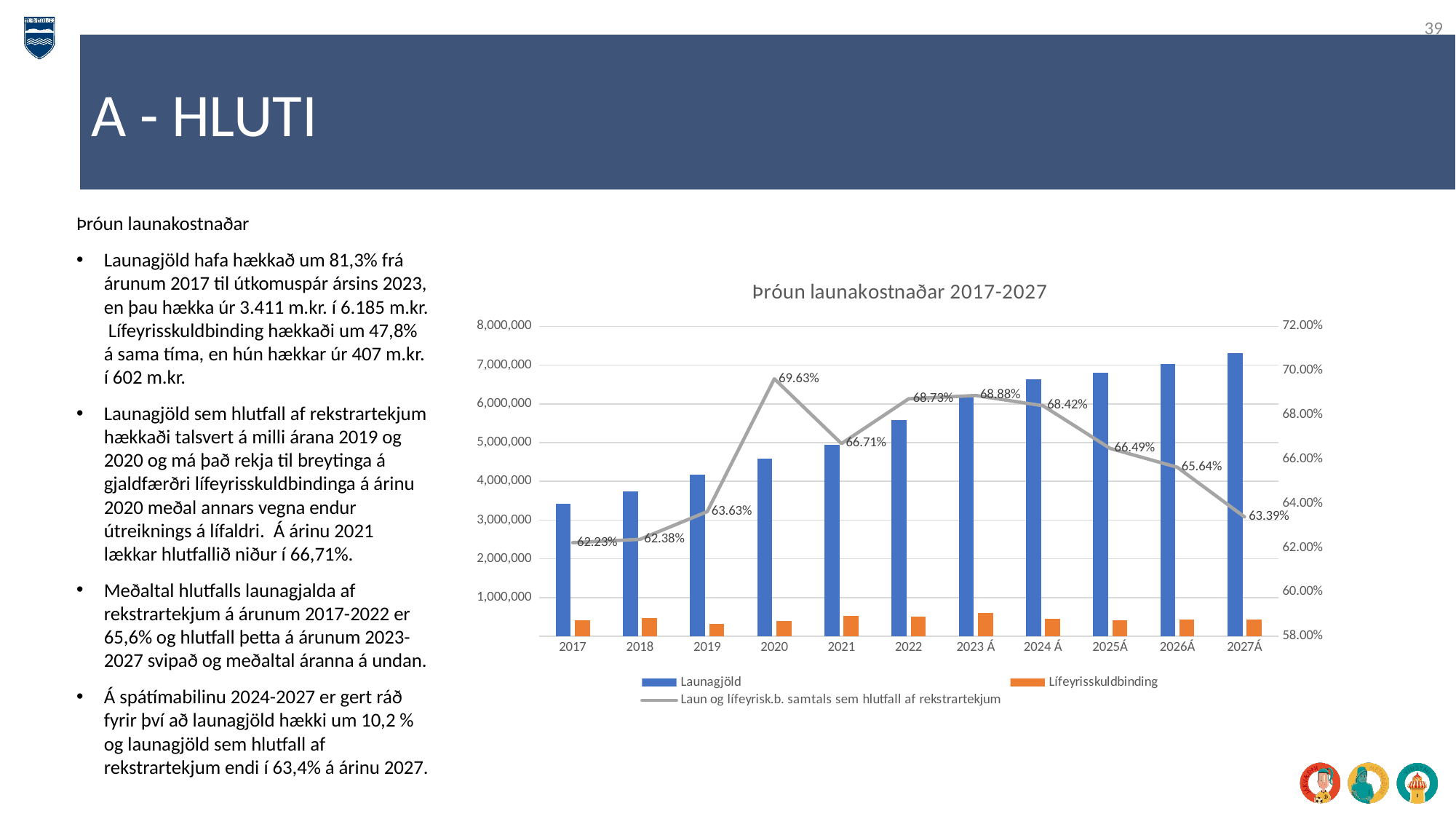
What is the difference between the line series values for 2020 and 2021? 2.92 percentage points What is the value of the line series 'Laun og lífeyrisk.b. samtals sem hlutfall af rekstrartekjum' for 2020? 69.63% Does the Launagjöld series rise or fall from 2017 to 2027Á? rise What is the value of the line series for 2027Á? 63.39% In which year does the line series 'Laun og lífeyrisk.b. samtals sem hlutfall af rekstrartekjum' reach its highest value? 2020 How many years are shown on the x axis of the chart? 11 How many series does the chart legend list? 3 Is the Launagjöld value for 2027Á greater or less than 7,000,000? greater In which year is the line series at its lowest value? 2017 What is the value of the line series for 2021? 66.71% Which year has the larger line series value, 2022 or 2025Á? 2022 Is the Launagjöld value for 2020 greater or less than 5,000,000? less